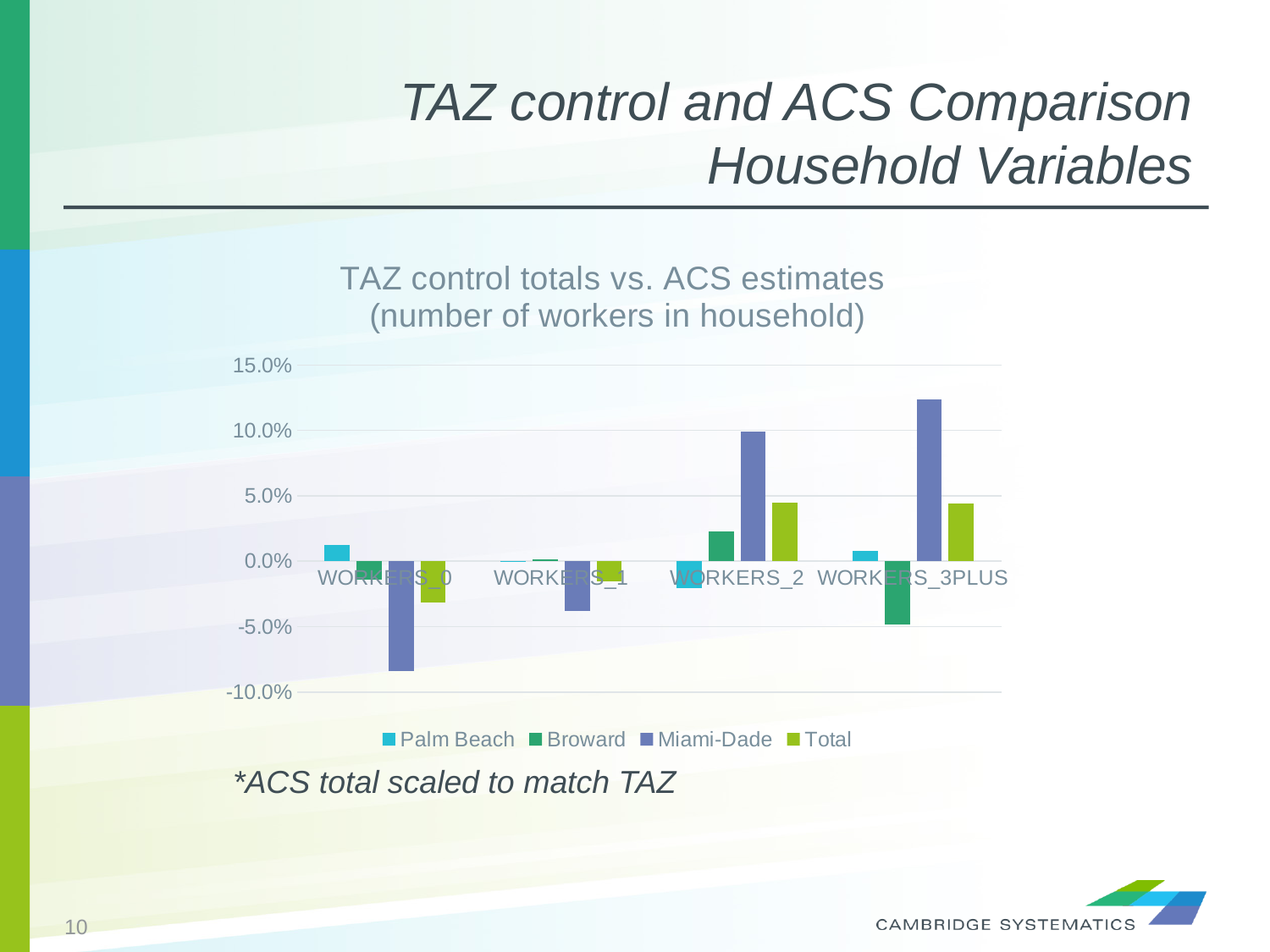
Is the Miami-Dade value for WORKERS_3PLUS greater or less than 10.0%? greater Is the Broward value for WORKERS_3PLUS greater or less than 0.0%? less Is the Miami-Dade value for WORKERS_2 greater or less than 5.0%? greater Which is larger: the Miami-Dade value for WORKERS_2 or for WORKERS_3PLUS? WORKERS_3PLUS Which category has the lowest Miami-Dade value? WORKERS_0 How many series does the chart's legend list? 4 What kind of chart is shown on the slide? bar chart What is the title of the chart? TAZ control totals vs. ACS estimates (number of workers in household) Which series are listed in the chart's legend? Palm Beach, Broward, Miami-Dade, Total How many categories are shown on the x axis of the chart? 4 Which category has the highest Miami-Dade value? WORKERS_3PLUS